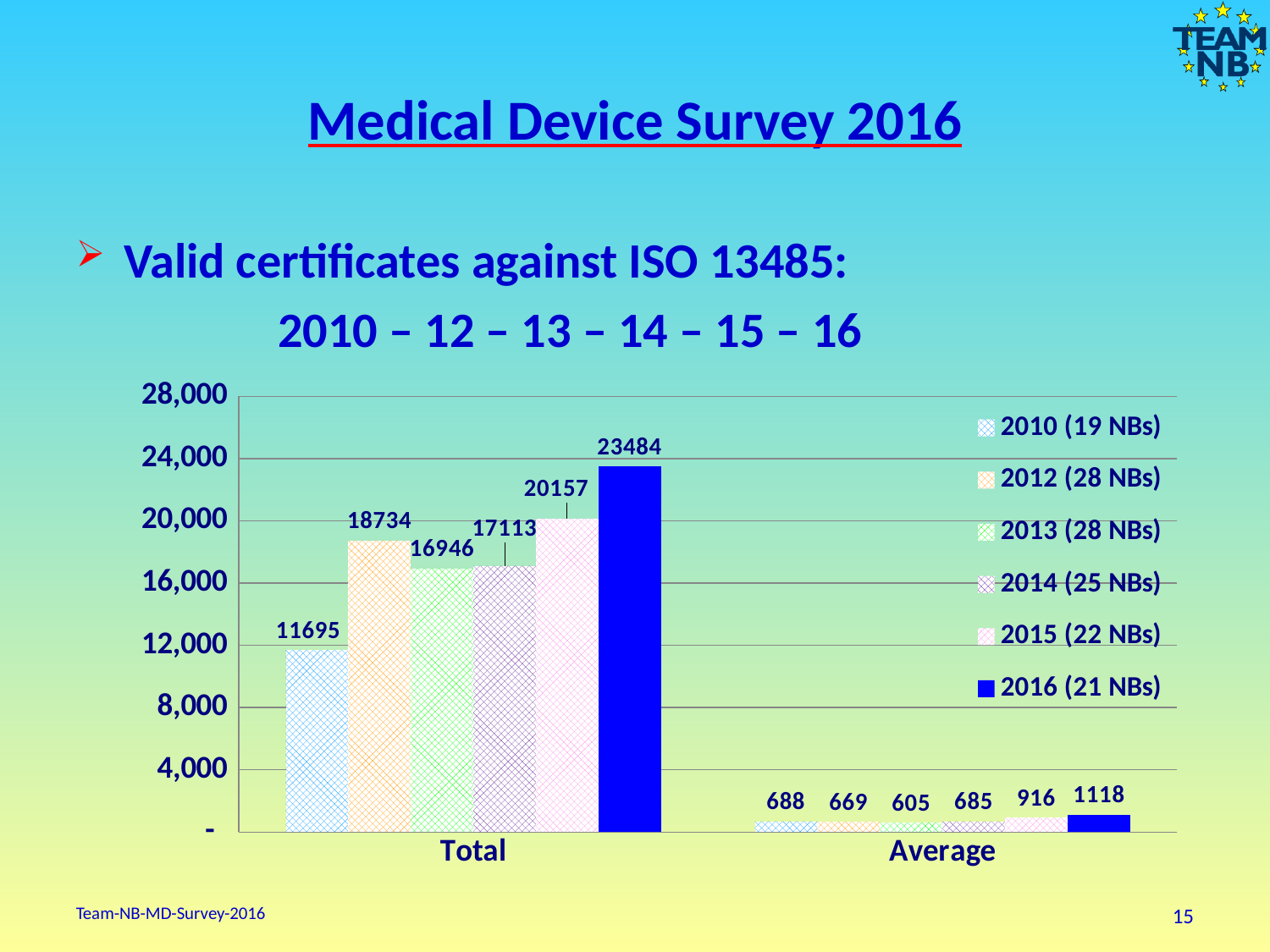
What kind of chart is shown on the slide? bar chart Which series has the highest Total value? 2016 (21 NBs) What is the Total value for the 2010 (19 NBs) series? 11695 How many categories are shown on the x axis? 2 What is the difference between the Average values for 2016 (21 NBs) and 2015 (22 NBs)? 202 Which is larger, the Total value for 2012 (28 NBs) or for 2014 (25 NBs)? 2012 (28 NBs) What is the Average value for the 2013 (28 NBs) series? 605 Is the Total value for 2015 (22 NBs) greater or less than 20,000? greater Which series has the lowest Average value? 2013 (28 NBs) How many series does the legend list? 6 What is the Total value for the 2016 (21 NBs) series? 23484 What is the difference between the Total values for 2016 (21 NBs) and 2015 (22 NBs)? 3327